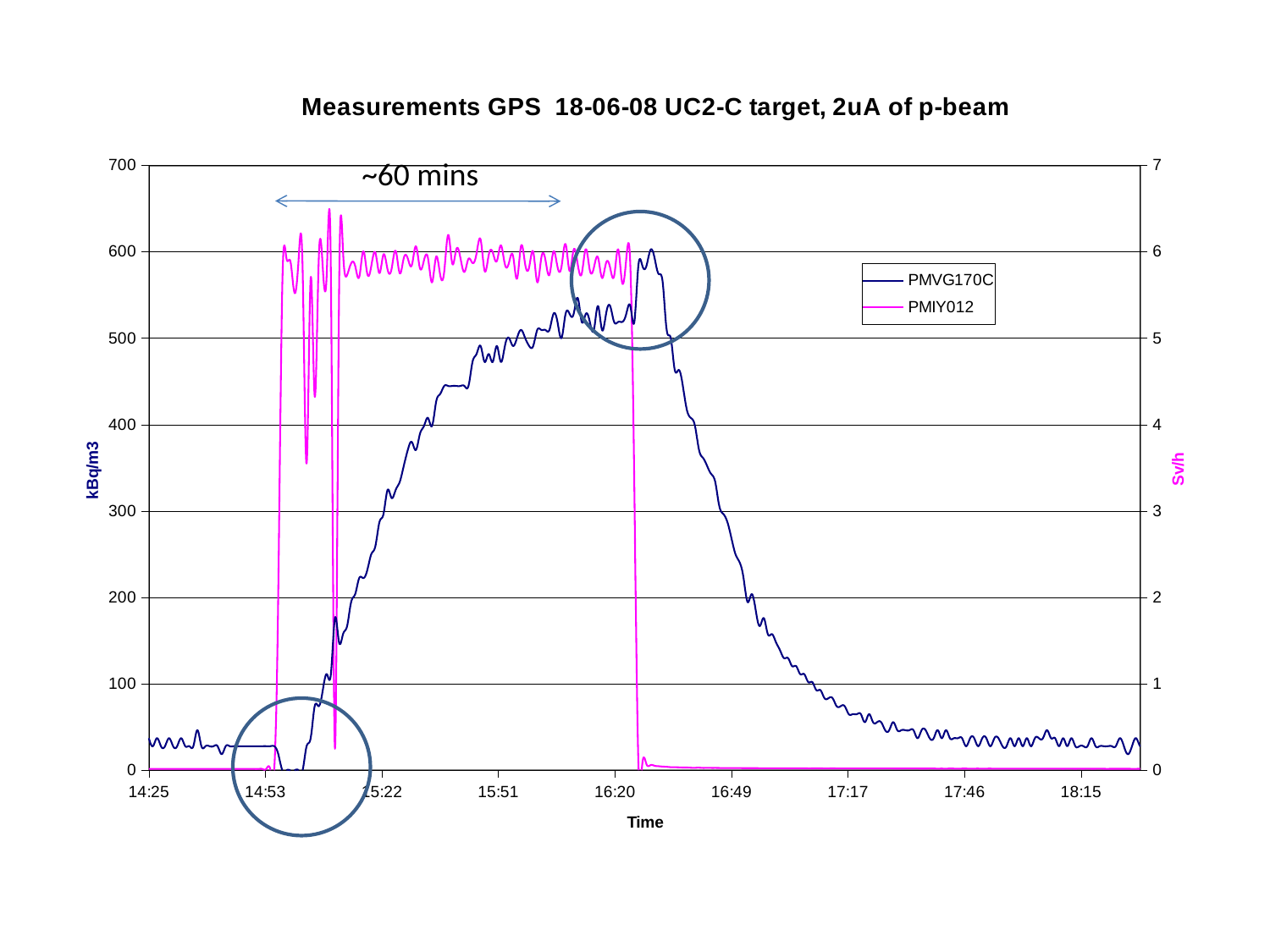
Does the PMVG170C line rise or fall between 16:49 and 17:46? fall Is the value of PMVG170C at 15:51 greater or less than 400? greater At 15:51, which series is higher on its own axis scale relative to the axis maximum, PMVG170C (left axis, max 700) or PMIY012 (right axis, max 7)? PMIY012 Is the value of PMVG170C at 17:46 greater or less than 100? less What is the label of the right-hand vertical axis? Sv/h How many series does the legend list? 2 Does the PMVG170C line rise or fall between 15:22 and 15:51? rise Is the value of PMVG170C at 14:25 greater or less than 100? less What is the title of the chart? Measurements GPS 18-06-08 UC2-C target, 2uA of p-beam What kind of chart is shown on the slide? Line chart